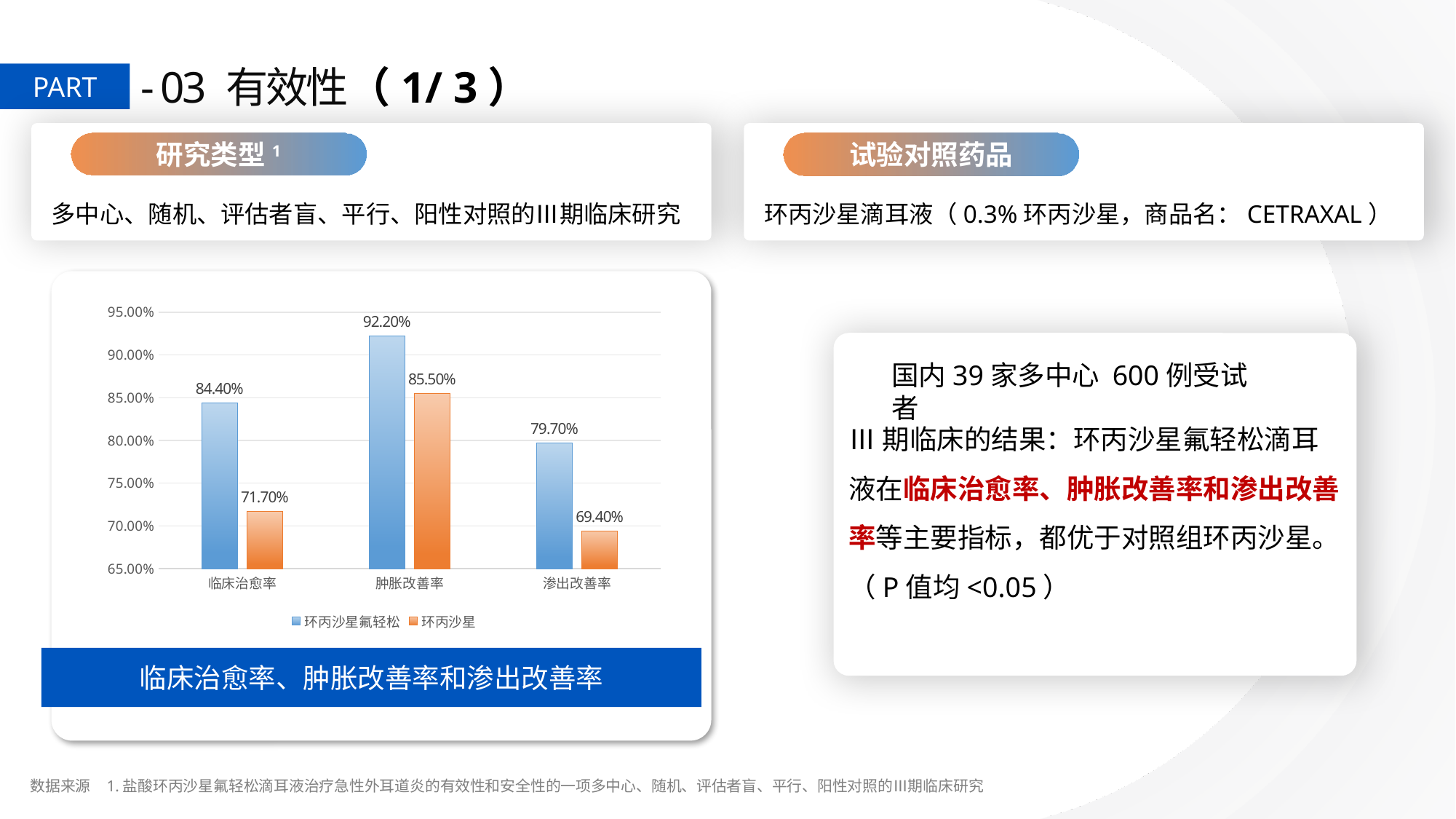
What kind of chart is shown on the slide? bar chart What is the difference between 环丙沙星氟轻松 and 环丙沙星 in the 肿胀改善率 category? 6.70% In which category does 环丙沙星氟轻松 have its highest value? 肿胀改善率 What is the difference between 环丙沙星氟轻松 and 环丙沙星 in the 临床治愈率 category? 12.70% What is the value for 环丙沙星 in the 肿胀改善率 category? 85.50% How many categories are shown on the x axis of the chart? 3 How many series does the chart legend list? 2 Which series has the larger value in the 渗出改善率 category, 环丙沙星氟轻松 or 环丙沙星? 环丙沙星氟轻松 What is the value for 环丙沙星氟轻松 in the 临床治愈率 category? 84.40% What is the value for 环丙沙星 in the 渗出改善率 category? 69.40% Is the value for 环丙沙星 in the 临床治愈率 category greater or less than 75.00%? less In which category does 环丙沙星 have its lowest value? 渗出改善率